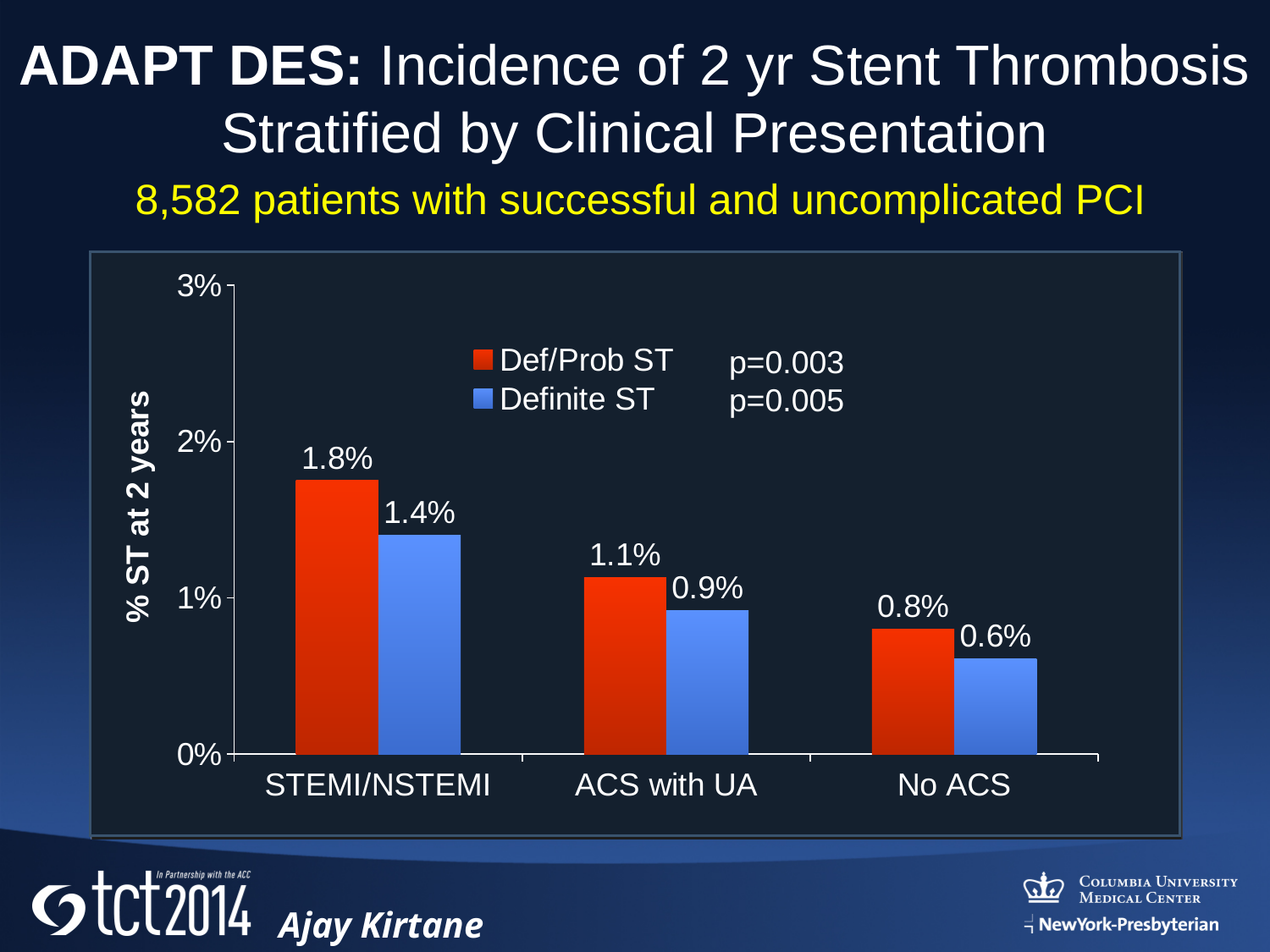
Which is larger: the Def/Prob ST value for ACS with UA or the Def/Prob ST value for No ACS? ACS with UA What is the Def/Prob ST value for STEMI/NSTEMI? 1.8% What is the y-axis label of the chart? % ST at 2 years What is the difference between the Def/Prob ST and Definite ST values for STEMI/NSTEMI? 0.4% Which category has the lowest Def/Prob ST value? No ACS What kind of chart is shown? Bar chart What is the Def/Prob ST value for No ACS? 0.8% Which category has the highest Definite ST value? STEMI/NSTEMI How many series does the legend list? 2 How many categories are shown on the x axis? 3 What is the Definite ST value for ACS with UA? 0.9% Do the Def/Prob ST values rise or fall from STEMI/NSTEMI to No ACS? Fall